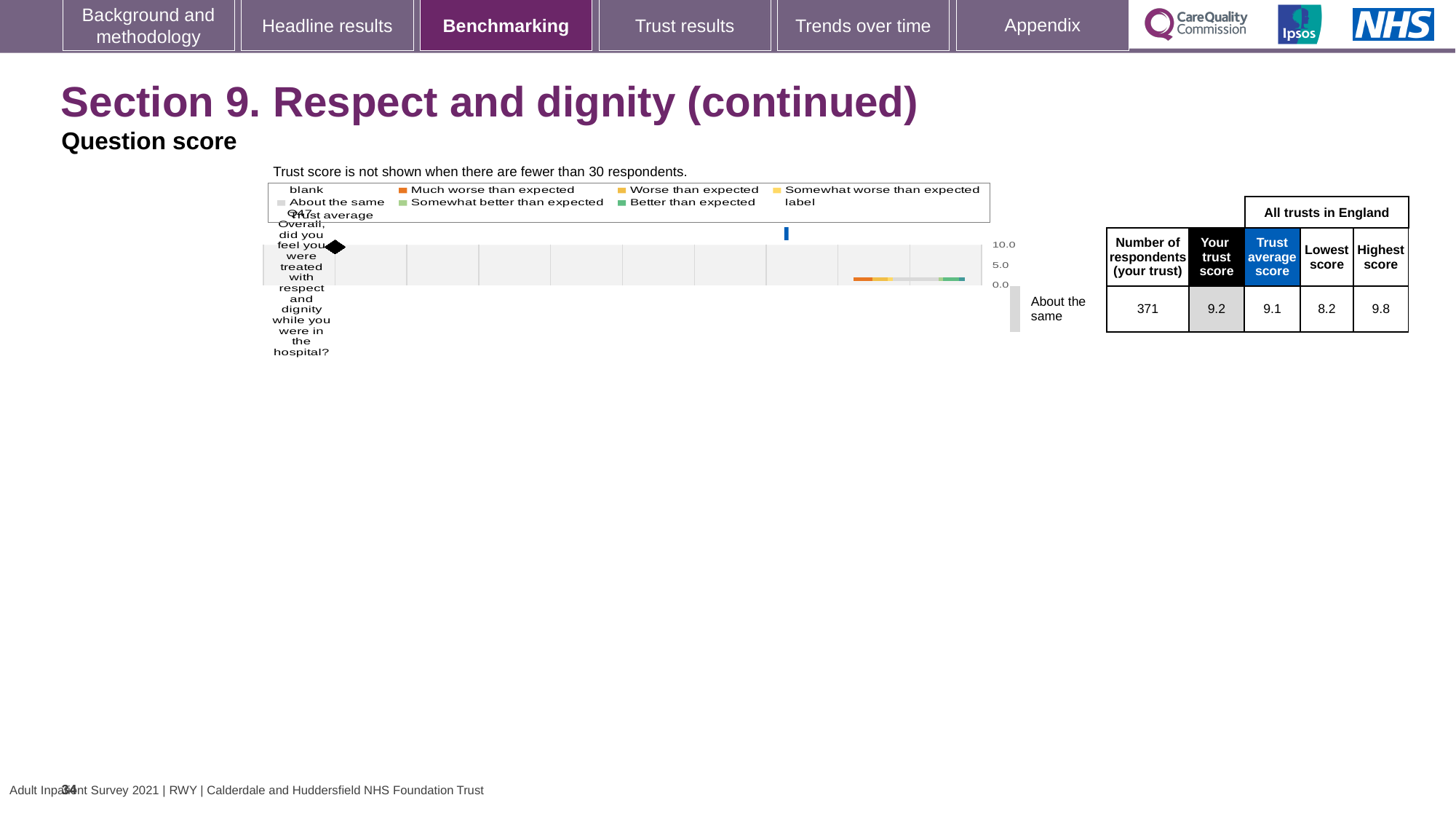
What is the difference between the highest score and the lowest score for Q47? 1.6 Which is larger for Q47: your trust score or the trust average score? Your trust score How many respondents from the trust answered Q47? 371 Is the trust score for Q47 greater or less than 5.0 on the chart's axis? greater What is the lowest score across all trusts in England for Q47? 8.2 What is the trust score for Q47 shown in the table next to the chart? 9.2 What benchmark category is the trust's Q47 score placed in? About the same What is the highest value shown on the chart's score axis? 10.0 How many questions (categories) are plotted on the chart? 1 What is the highest score across all trusts in England for Q47? 9.8 What kind of chart is shown on the slide? bar chart What is the trust average score for Q47 shown in the table? 9.1